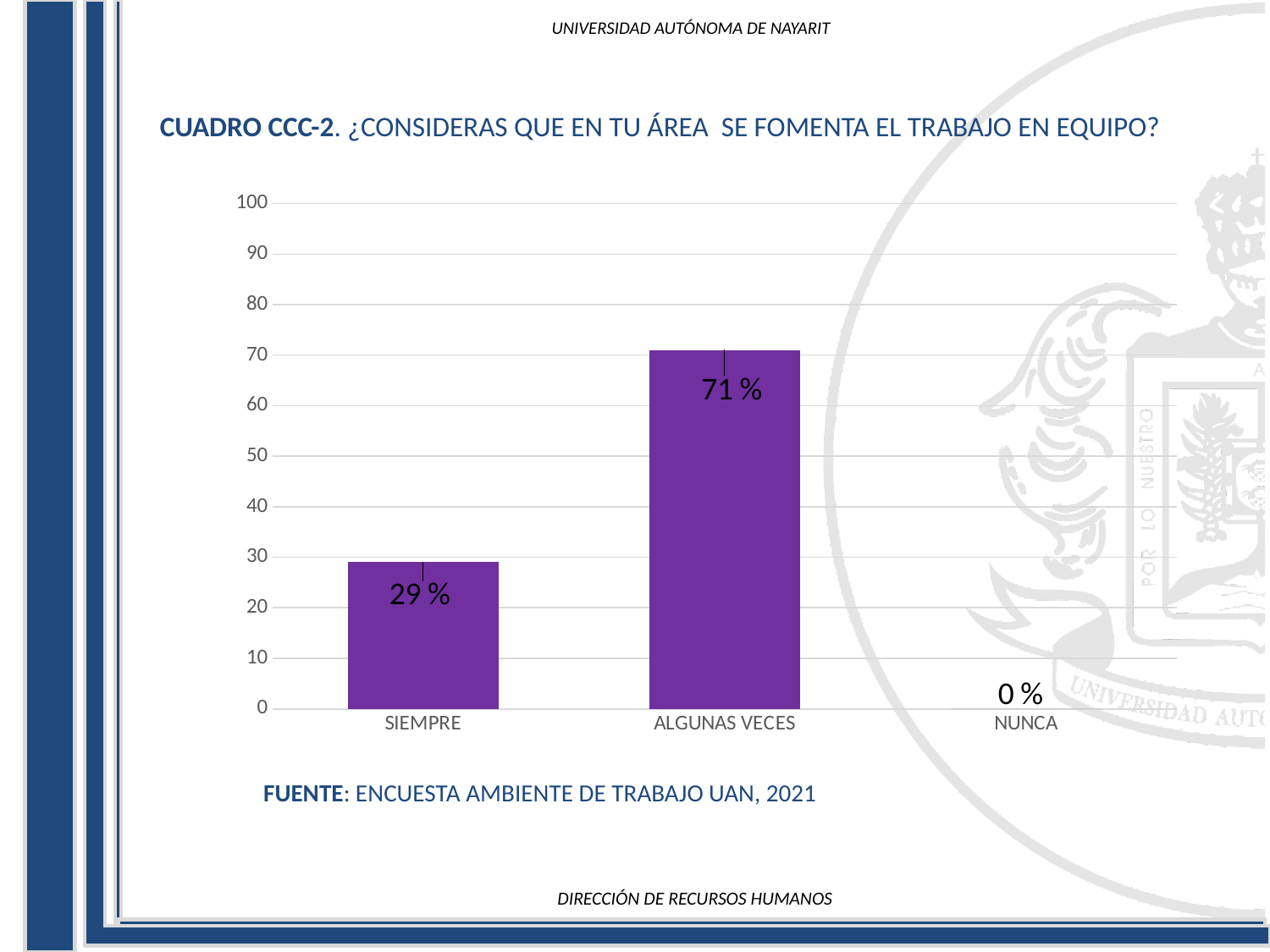
Which category has the highest value? ALGUNAS VECES What is the source cited below the chart? ENCUESTA AMBIENTE DE TRABAJO UAN, 2021 What is the value for NUNCA? 0 % How many categories are shown on the x axis? 3 Which is larger, the value for SIEMPRE or the value for ALGUNAS VECES? ALGUNAS VECES What kind of chart is shown on the slide? bar chart What is the value for SIEMPRE? 29 % Is the value for SIEMPRE greater or less than 40? less What is the difference between the values for ALGUNAS VECES and SIEMPRE? 42 % What is the value for ALGUNAS VECES? 71 % Is the value for ALGUNAS VECES greater or less than 60? greater Which category has the lowest value? NUNCA